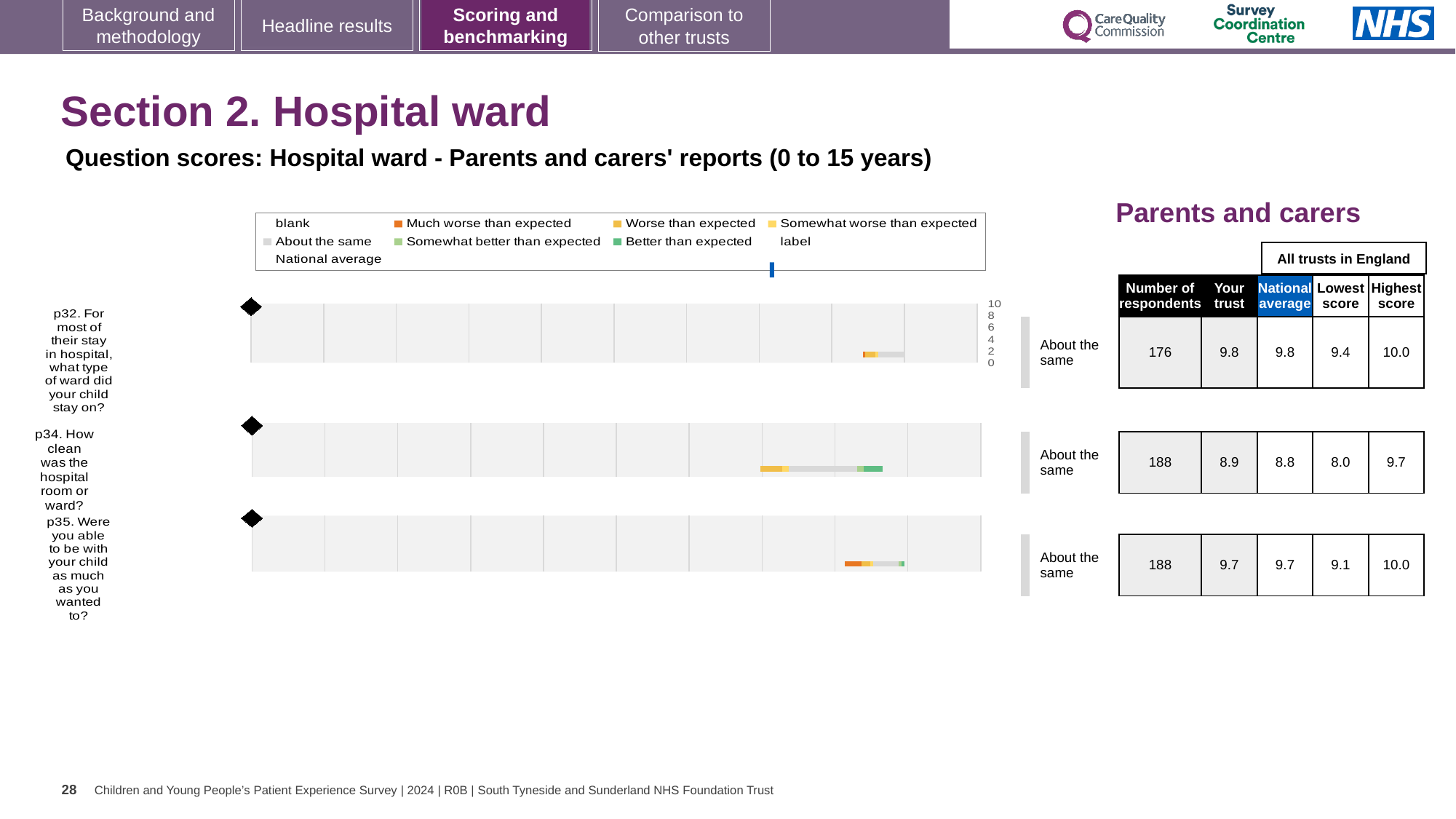
For p34, what is the difference between the highest score and the lowest score across all trusts in England? 1.7 What benchmark category is shown next to the chart for p32? About the same For p34, is the 'Your trust' score or the national average higher? Your trust What is the national average score shown for p32 (what type of ward did your child stay on?)? 9.8 What is the lowest score across all trusts in England for p35? 9.1 What is the highest score across all trusts in England for p34? 9.7 Which of the three questions has the lowest 'Lowest score' across all trusts in England? p34 How many respondents are listed for p35 (Were you able to be with your child as much as you wanted to?)? 188 Which of the three questions has the lowest 'Your trust' score? p34 How many survey questions are plotted on this slide? 3 In the table beside the charts, what is the 'Your trust' score for p34 (How clean was the hospital room or ward?)? 8.9 What type of chart is used to show the question scores? Bar chart